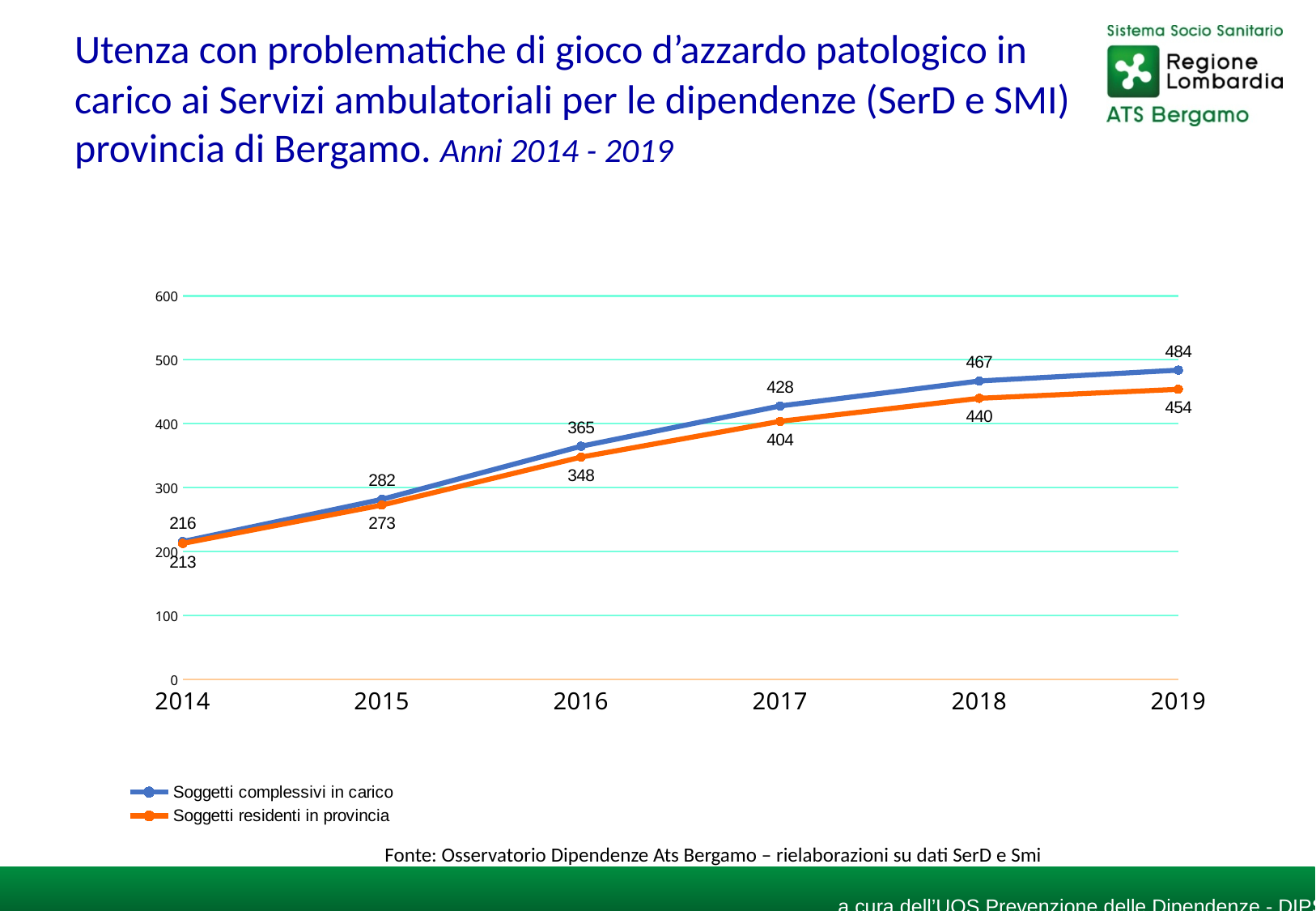
How many years are shown on the x axis? 6 In which year is 'Soggetti residenti in provincia' lowest? 2014 How many series does the legend list? 2 What is the value for 'Soggetti residenti in provincia' in 2019? 454 Do the values for 'Soggetti complessivi in carico' rise or fall from 2014 to 2019? rise What is the value for 'Soggetti complessivi in carico' in 2017? 428 Which is larger: 'Soggetti complessivi in carico' in 2016 or 'Soggetti residenti in provincia' in 2017? Soggetti residenti in provincia in 2017 In which year is 'Soggetti complessivi in carico' highest? 2019 What is the difference between 'Soggetti complessivi in carico' and 'Soggetti residenti in provincia' in 2018? 27 What is the value for 'Soggetti residenti in provincia' in 2016? 348 Is the value for 'Soggetti complessivi in carico' in 2015 greater or less than 300? less What kind of chart is shown on the slide? line chart